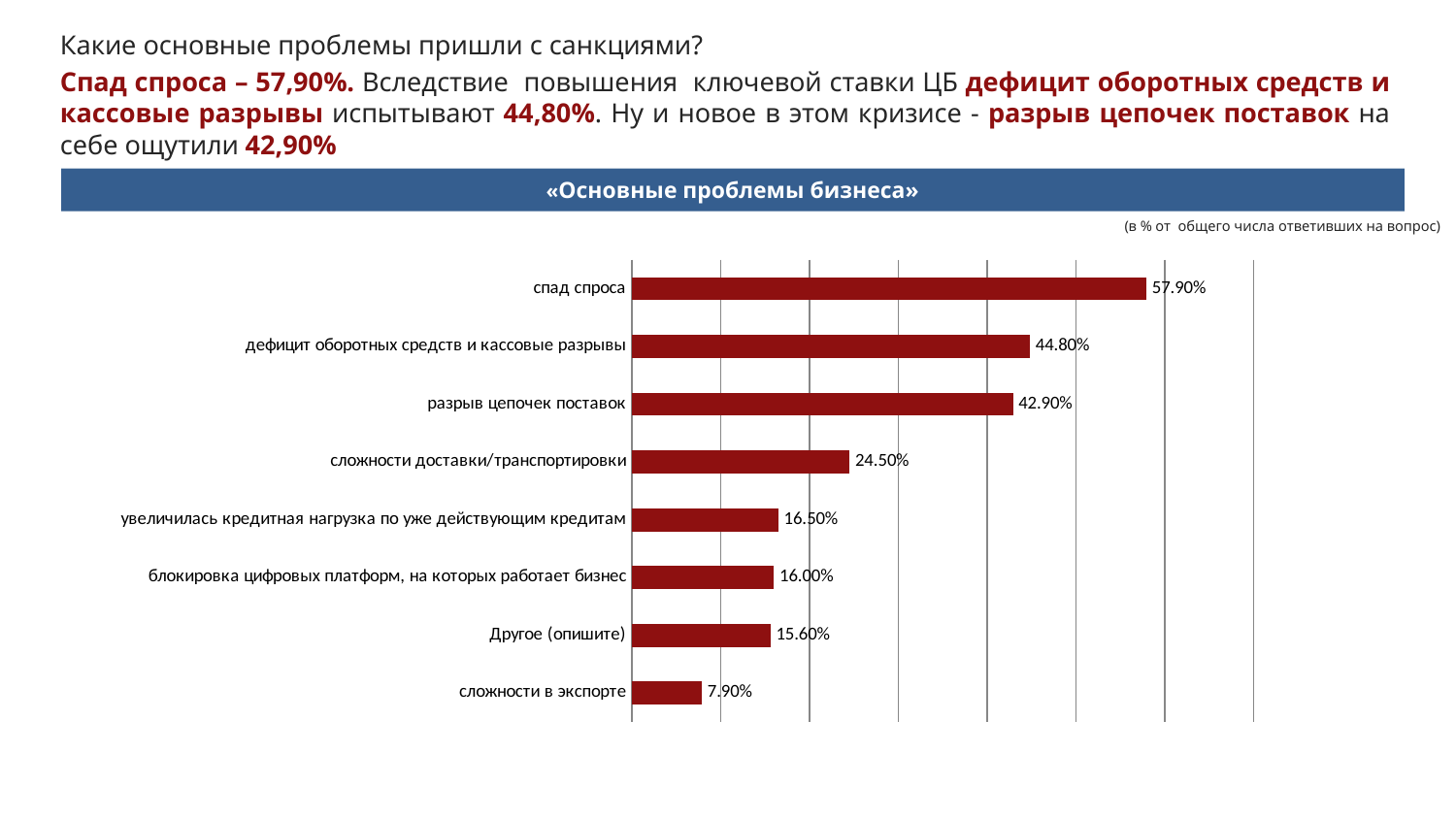
Which category has the highest value? спад спроса What is the value for «спад спроса»? 57.90% How many categories are shown in the chart? 8 What kind of chart is shown on the slide? bar chart Which category has the lowest value? сложности в экспорте Which is larger: «увеличилась кредитная нагрузка по уже действующим кредитам» or «Другое (опишите)»? увеличилась кредитная нагрузка по уже действующим кредитам What is the value for «разрыв цепочек поставок»? 42.90% What is the title of the chart? «Основные проблемы бизнеса» What is the value for «сложности в экспорте»? 7.90% What is the difference between «спад спроса» and «дефицит оборотных средств и кассовые разрывы»? 13.10% What is the difference between «разрыв цепочек поставок» and «сложности доставки/транспортировки»? 18.40% What is the value for «сложности доставки/транспортировки»? 24.50%